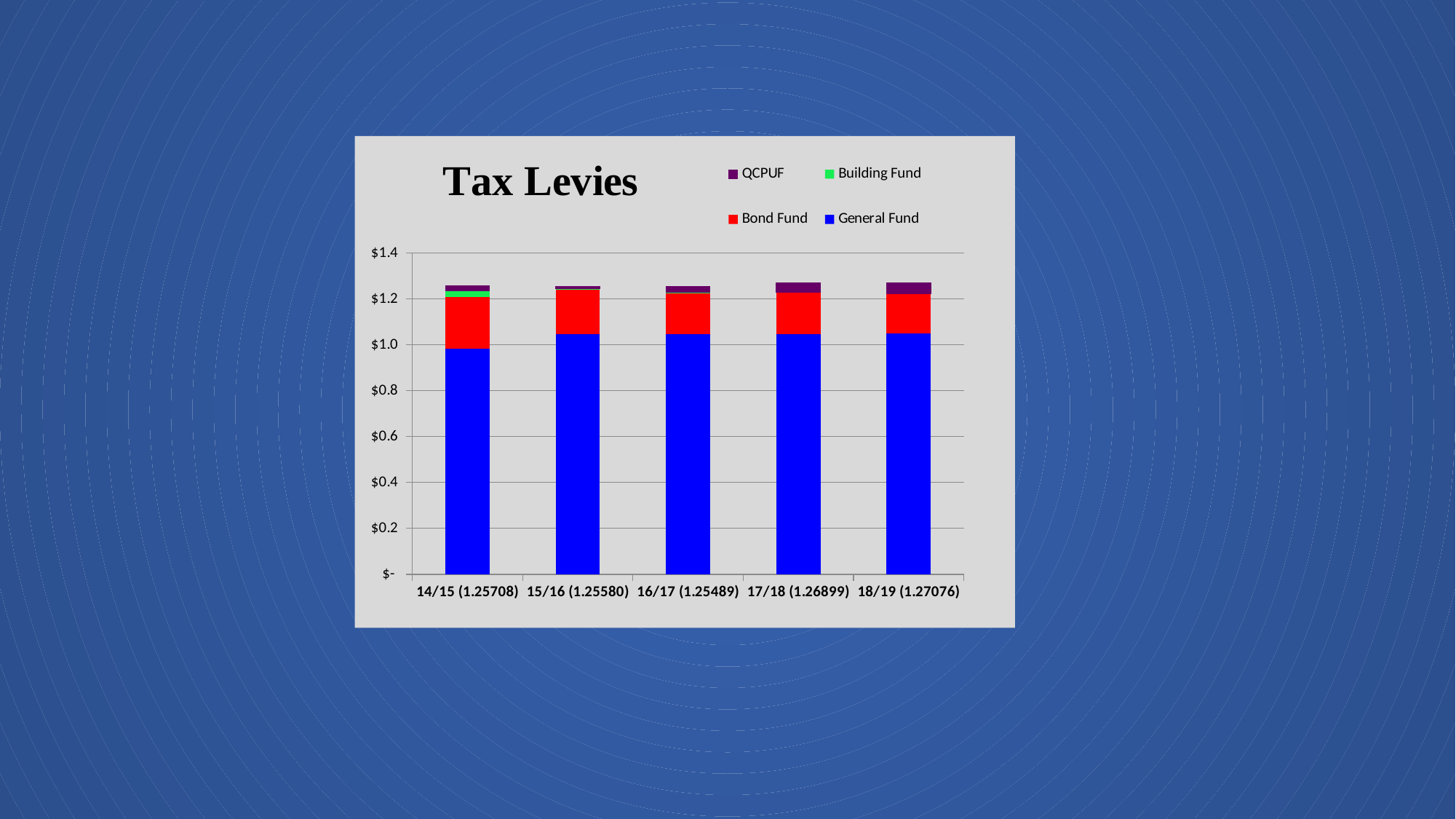
Is the General Fund value for 14/15 greater or less than $1.0? less Based on the totals printed in the category labels, which year has the highest total tax levy? 18/19 (1.27076) What is the difference between the total printed for 18/19 and the total printed for 14/15? 0.01368 Which series is shown in blue? General Fund What kind of chart is shown on the slide? Stacked bar chart How many series does the legend list? 4 Which is larger, the General Fund value for 14/15 or for 15/16? 15/16 What total tax levy is printed in the category label for 17/18? 1.26899 What is the title of the chart? Tax Levies How many fiscal years (categories) are shown on the x axis? 5 Based on the totals printed in the category labels, which year has the lowest total tax levy? 16/17 (1.25489) What total tax levy is printed in the category label for 14/15? 1.25708